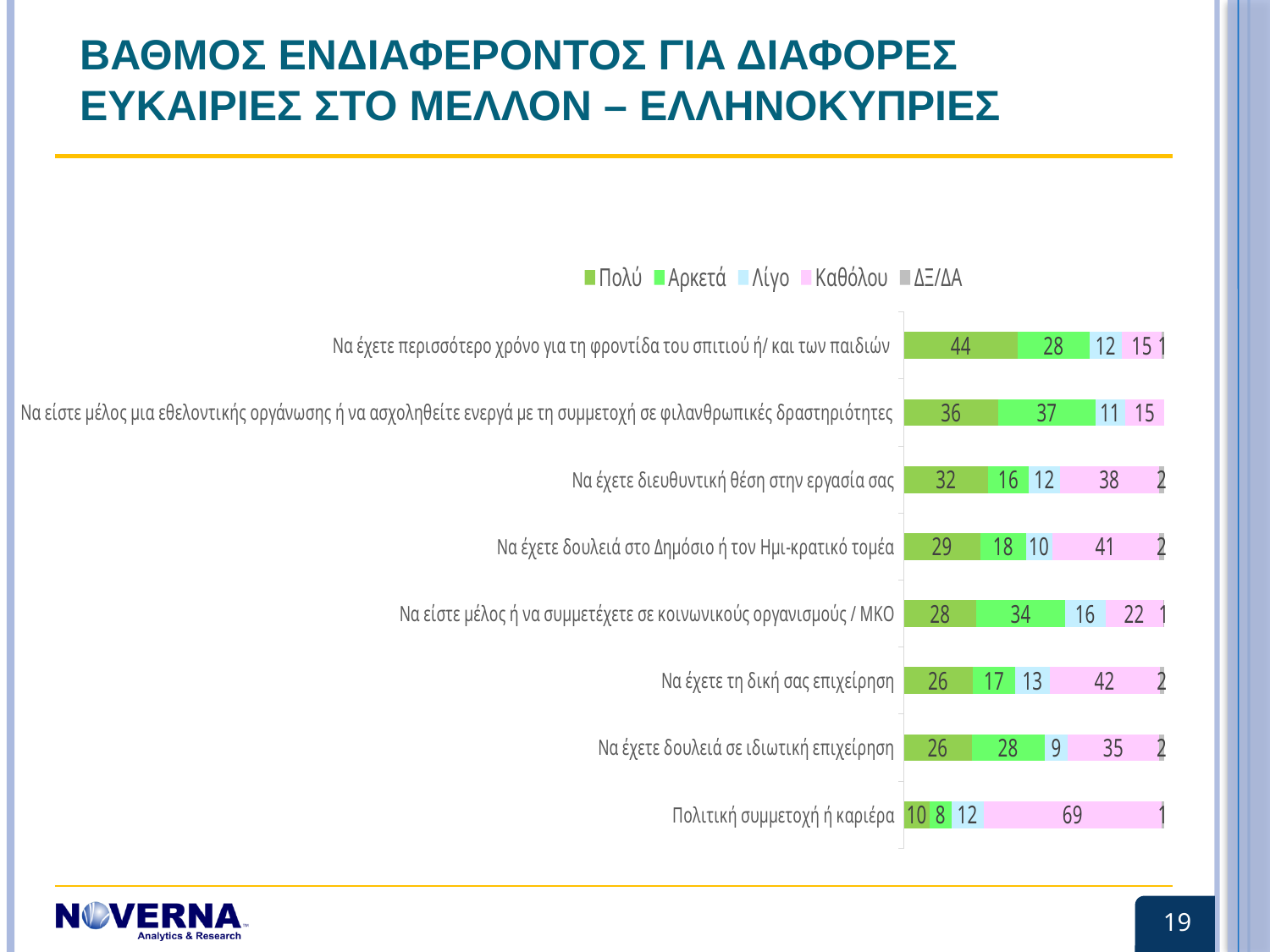
Which is larger: the 'Αρκετά' value for 'Να είστε μέλος μια εθελοντικής οργάνωσης ή να ασχοληθείτε ενεργά με τη συμμετοχή σε φιλανθρωπικές δραστηριότητες' or for 'Να έχετε διευθυντική θέση στην εργασία σας'? Να είστε μέλος μια εθελοντικής οργάνωσης ή να ασχοληθείτε ενεργά με τη συμμετοχή σε φιλανθρωπικές δραστηριότητες Which legend entry is shown in pink? Καθόλου What is the 'Αρκετά' value for 'Να είστε μέλος ή να συμμετέχετε σε κοινωνικούς οργανισμούς / ΜΚΟ'? 34 Which category has the lowest 'Πολύ' value? Πολιτική συμμετοχή ή καριέρα Which category has the highest 'Πολύ' value? Να έχετε περισσότερο χρόνο για τη φροντίδα του σπιτιού ή/ και των παιδιών What is the 'Καθόλου' value for 'Πολιτική συμμετοχή ή καριέρα'? 69 What is the 'Πολύ' value for 'Να έχετε περισσότερο χρόνο για τη φροντίδα του σπιτιού ή/ και των παιδιών'? 44 What is the difference between the 'Καθόλου' values for 'Να έχετε τη δική σας επιχείρηση' and 'Να έχετε δουλειά σε ιδιωτική επιχείρηση'? 7 What is the total of the stacked bar for 'Να έχετε περισσότερο χρόνο για τη φροντίδα του σπιτιού ή/ και των παιδιών'? 100 How many categories (bars) are shown in the chart? 8 How many series does the legend list? 5 What kind of chart is shown on the slide? Stacked bar chart